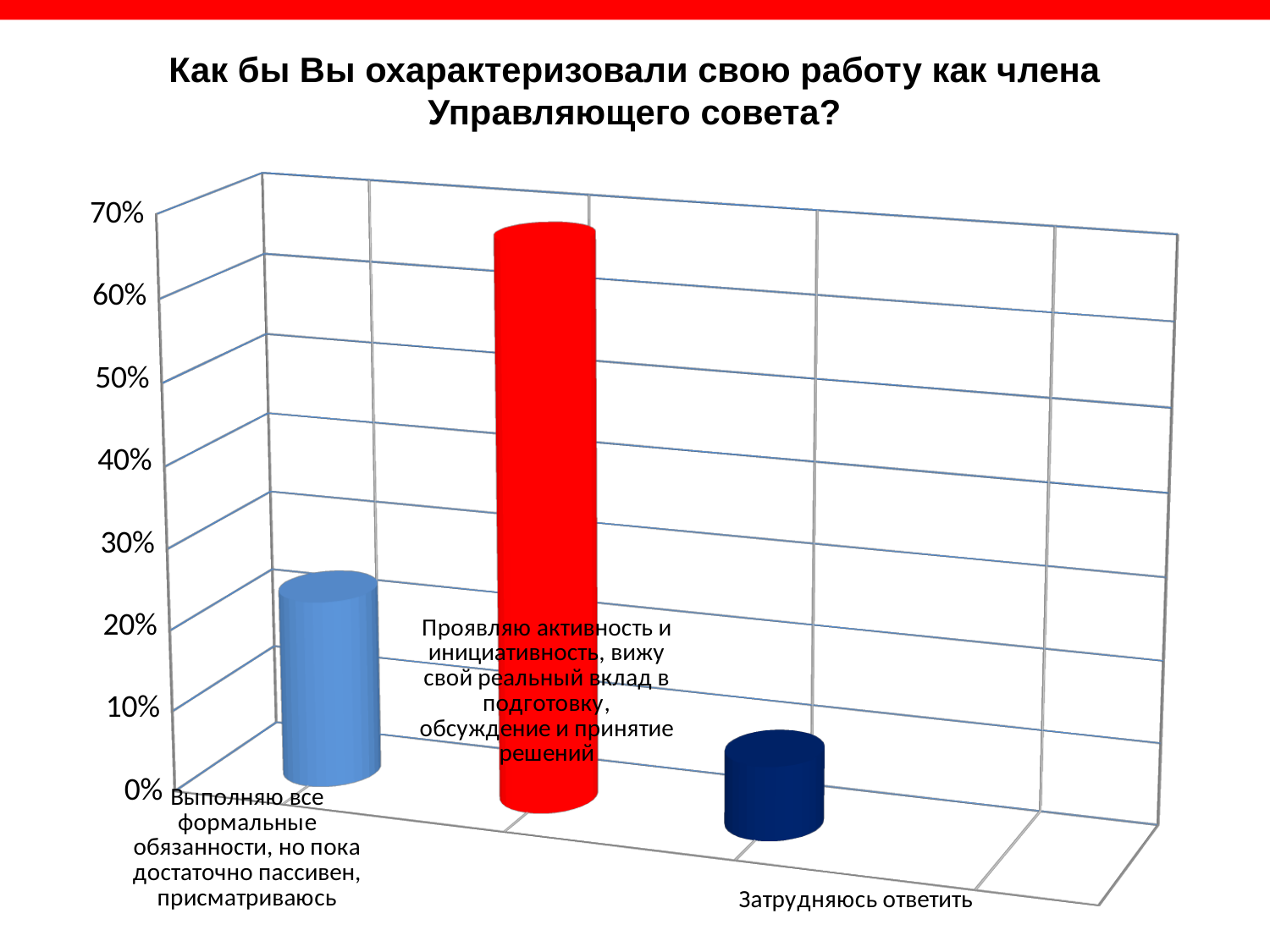
Which category has the highest value? Проявляю активность и инициативность, вижу свой реальный вклад в подготовку, обсуждение и принятие решений What kind of chart is shown on the slide? bar chart What is the title of the slide? Как бы Вы охарактеризовали свою работу как члена Управляющего совета? Is the value for "Проявляю активность и инициативность, вижу свой реальный вклад в подготовку, обсуждение и принятие решений" greater or less than 50%? greater What is the highest value shown on the vertical axis? 70% Which is larger: the value for "Выполняю все формальные обязанности, но пока достаточно пассивен, присматриваюсь" or the value for "Затрудняюсь ответить"? Выполняю все формальные обязанности, но пока достаточно пассивен, присматриваюсь Is the value for "Выполняю все формальные обязанности, но пока достаточно пассивен, присматриваюсь" greater or less than 40%? less Which category has the lowest value? Затрудняюсь ответить How many categories are plotted in the chart? 3 Is the value for "Выполняю все формальные обязанности, но пока достаточно пассивен, присматриваюсь" greater or less than 10%? greater What colour is the bar for "Проявляю активность и инициативность, вижу свой реальный вклад в подготовку, обсуждение и принятие решений"? red